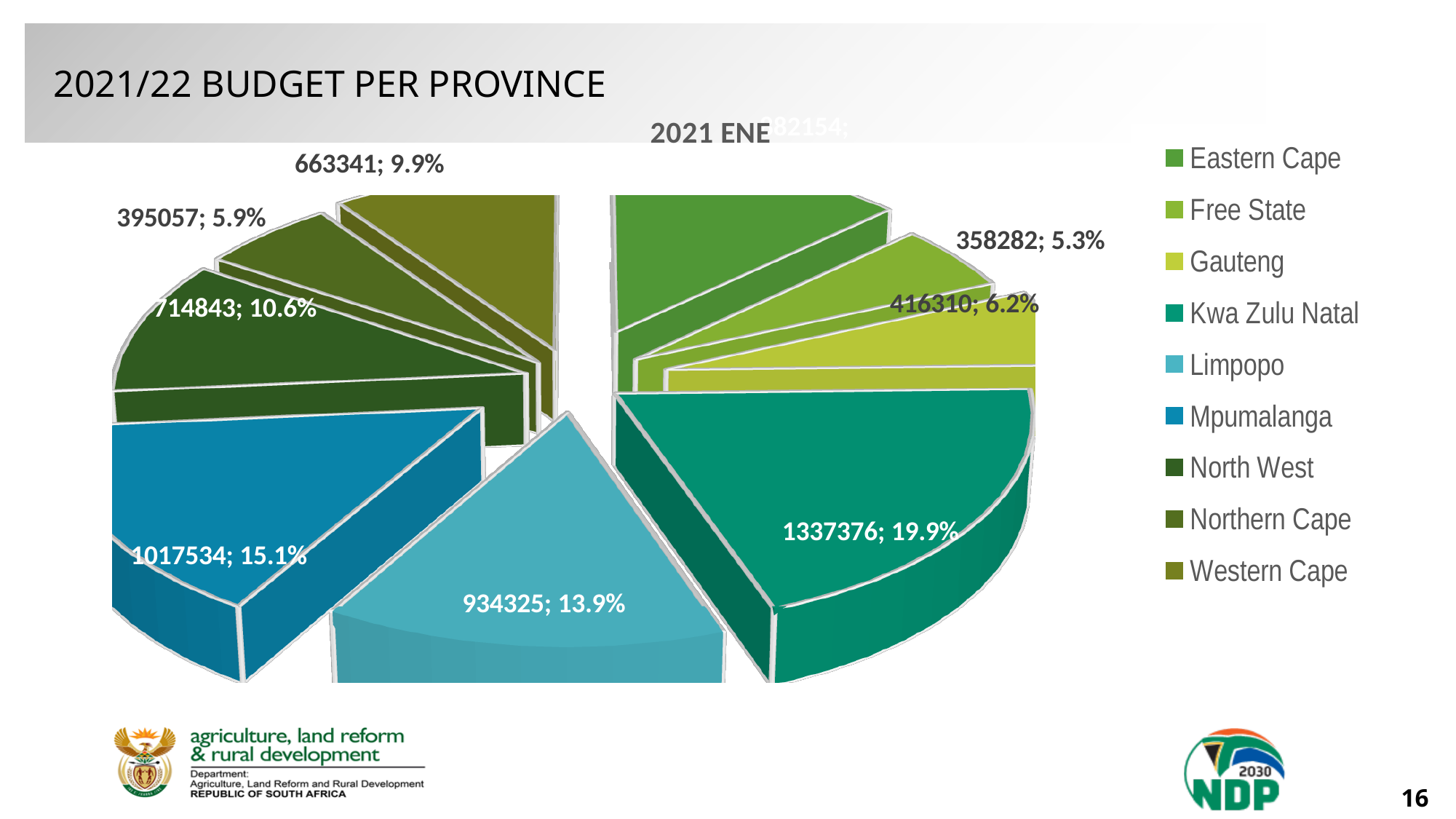
How many provinces are listed in the legend? 9 What percentage share does Free State have? 5.3% Which has a larger budget, North West or Western Cape? North West What is the budget value shown for Kwa Zulu Natal? 1337376 What kind of chart is shown on the slide? Pie chart What is the title of the chart? 2021 ENE What is the budget value shown for Gauteng? 416310 What is the budget value shown for Limpopo? 934325 Which province has the largest slice of the pie? Kwa Zulu Natal What is the difference between the budget values for Mpumalanga and Limpopo? 83209 What percentage share of the pie does Mpumalanga have? 15.1% Which province has the smallest slice of the pie? Free State